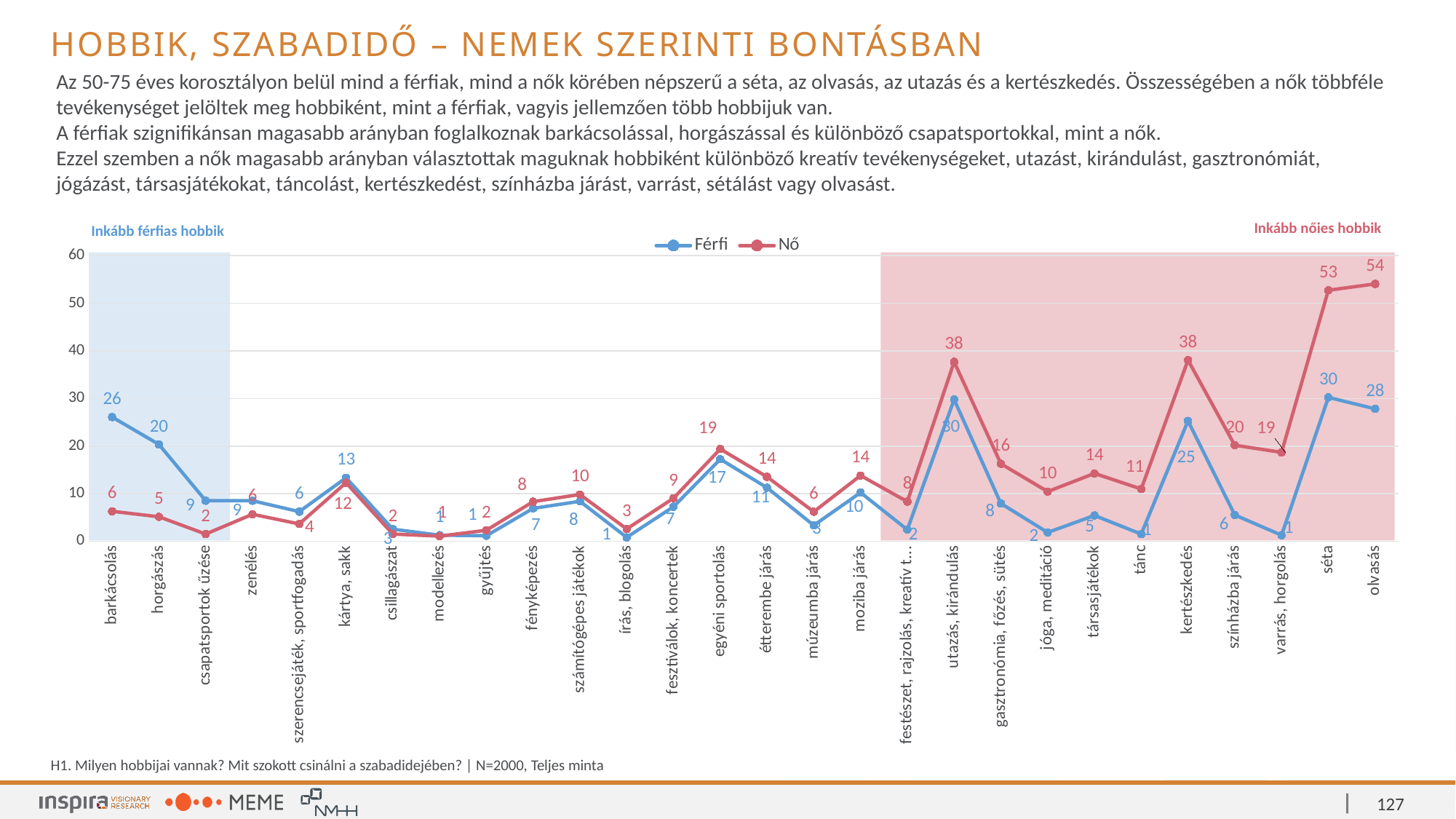
Is the value for Nő for séta greater or less than 50? greater What are the two series named in the legend? Férfi and Nő What is the difference between the Férfi and Nő values for horgászás? 15 For varrás, horgolás, which series has the larger value, Férfi or Nő? Nő What is the value for Nő for kertészkedés? 38 Which category has the highest value for Nő? olvasás What is the value for Férfi for barkácsolás? 26 What type of chart is shown on the slide? line chart What is the value for Nő for olvasás? 54 How many series does the legend list? 2 What is the difference between the Nő and Férfi values for séta? 23 What is the value for Férfi for utazás, kirándulás? 30